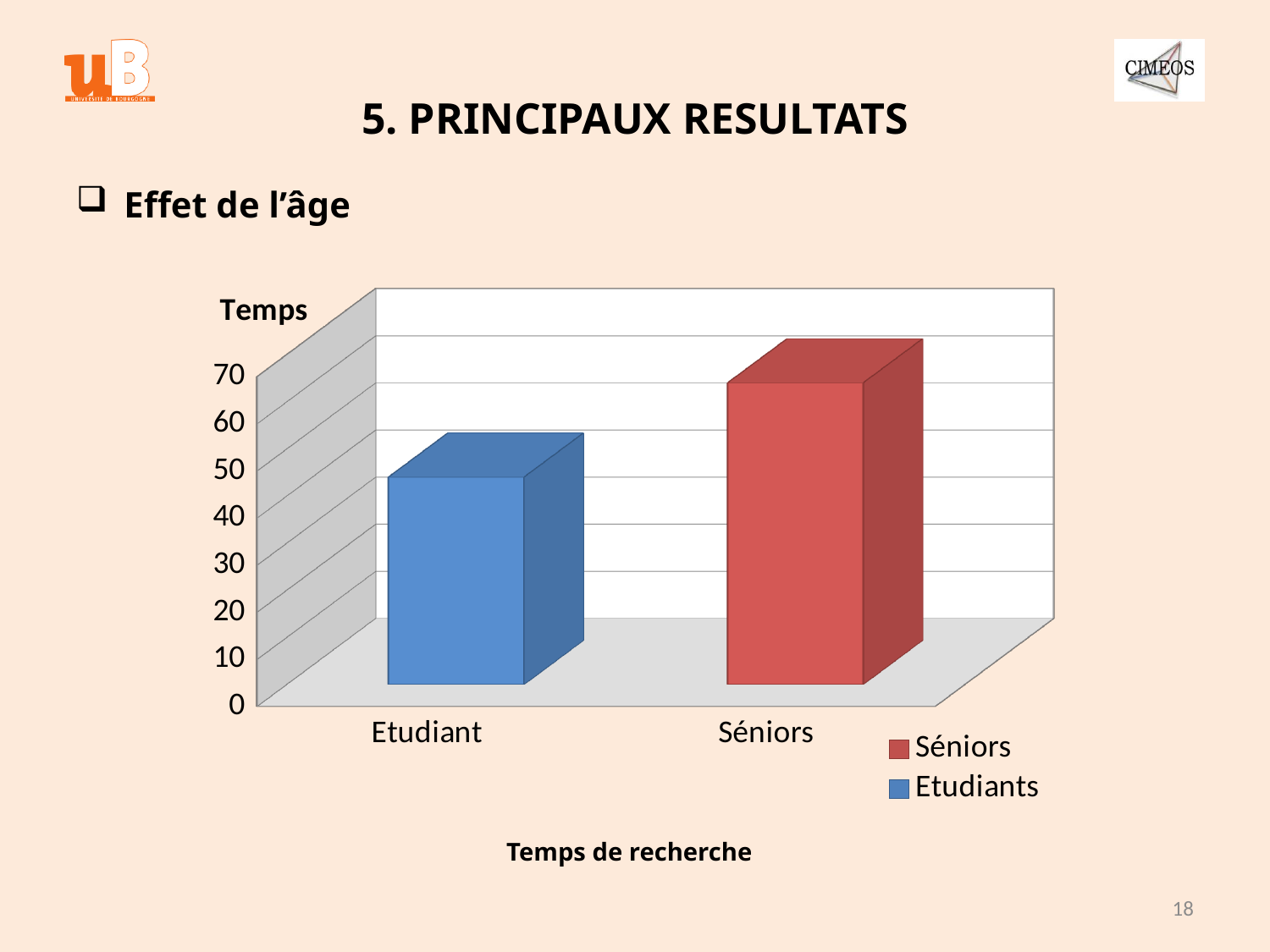
What is the title shown below the chart? Temps de recherche How many categories are shown on the x axis of the chart? 2 Is the value for Séniors greater or less than 50? greater Which bar is taller, Etudiant or Séniors? Séniors Is the value for Etudiant greater or less than 30? greater What colour is the Séniors bar in the chart? red How many entries does the chart legend list? 2 What kind of chart is shown on the slide? bar chart Is the value for Etudiant greater or less than 60? less Which category has the lowest bar in the chart? Etudiant Which category has the highest bar in the chart? Séniors